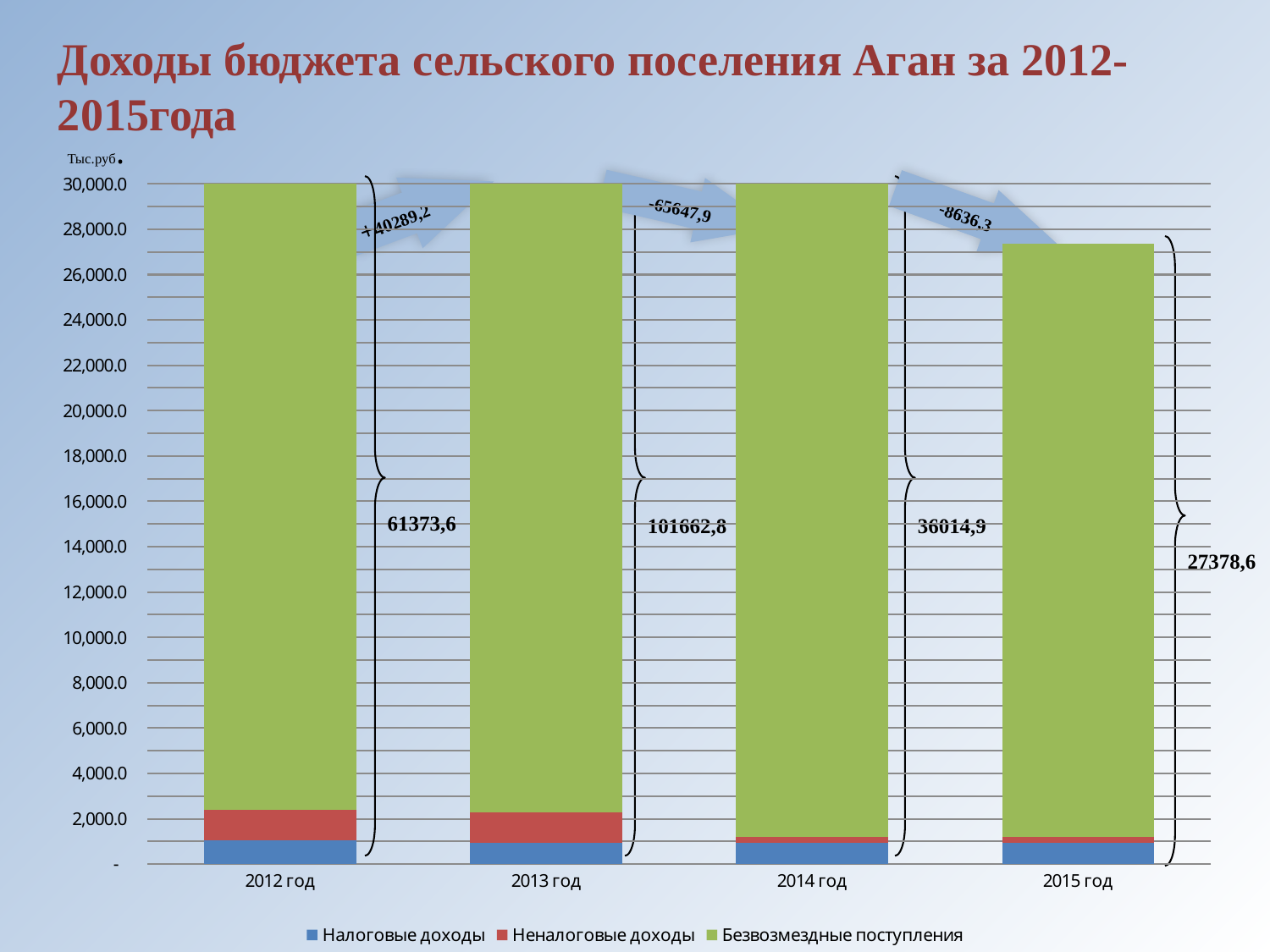
Which series is shown in green in the legend? Безвозмездные поступления Which year has the highest annotated total income? 2013 год Which year has the lowest annotated total income? 2015 год How many series does the legend list? 3 Is the top of the 2015 год bar greater or less than 28,000.0 on the axis? less What is the difference between the annotated totals for 2013 год and 2012 год? 40289,2 What total budget income is annotated for 2012 год? 61373,6 What total budget income is annotated for 2015 год? 27378,6 What total budget income is annotated for 2013 год? 101662,8 Which is larger, the annotated total for 2013 год or for 2014 год? 2013 год What kind of chart is shown on the slide? stacked bar chart How many years (categories) are shown on the x axis? 4